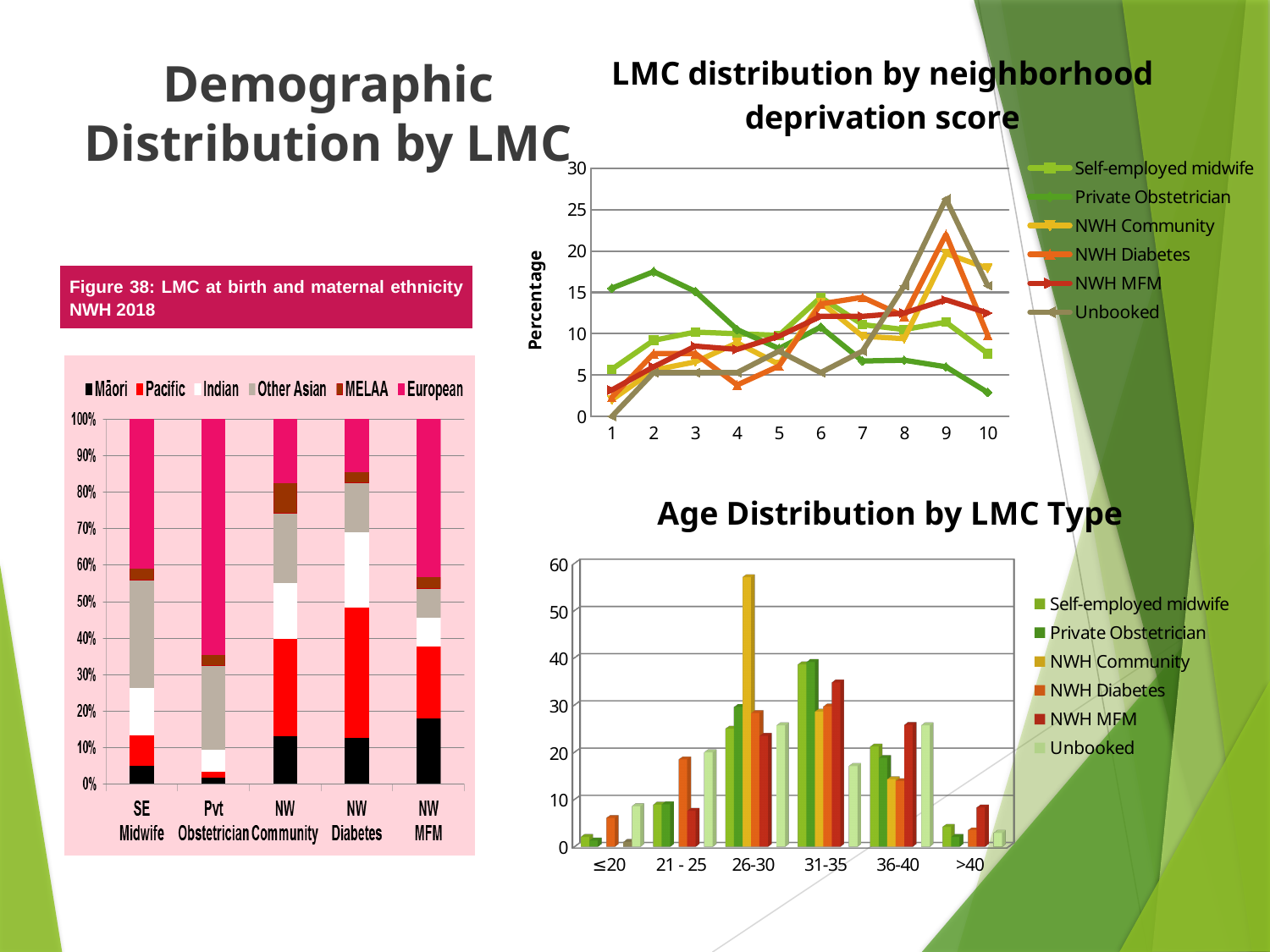
In the 'Figure 38: LMC at birth and maternal ethnicity NWH 2018' chart, which has the larger Pacific share, NW Community or NW Diabetes? NW Diabetes In the 'Age Distribution by LMC Type' chart, is the NWH Community value for the 26-30 age group greater or less than 50? greater In the 'Age Distribution by LMC Type' chart, is the Unbooked value for the ≤20 age group greater or less than 10? less In the 'LMC distribution by neighborhood deprivation score' chart, is the Private Obstetrician value at deprivation score 10 greater or less than 5? less In the 'LMC distribution by neighborhood deprivation score' chart, at which deprivation score does the Private Obstetrician series reach its highest value? 2 In the 'Age Distribution by LMC Type' chart, which LMC type has the highest value in the 26-30 age group? NWH Community How many series does the legend of the 'LMC distribution by neighborhood deprivation score' chart list? 6 What kind of chart is the 'Age Distribution by LMC Type' chart? bar chart How many age groups are shown on the x axis of the 'Age Distribution by LMC Type' chart? 6 How many deprivation score categories are shown on the x axis of the 'LMC distribution by neighborhood deprivation score' chart? 10 In the 'Figure 38: LMC at birth and maternal ethnicity NWH 2018' chart, which LMC has the largest Māori share? NW MFM